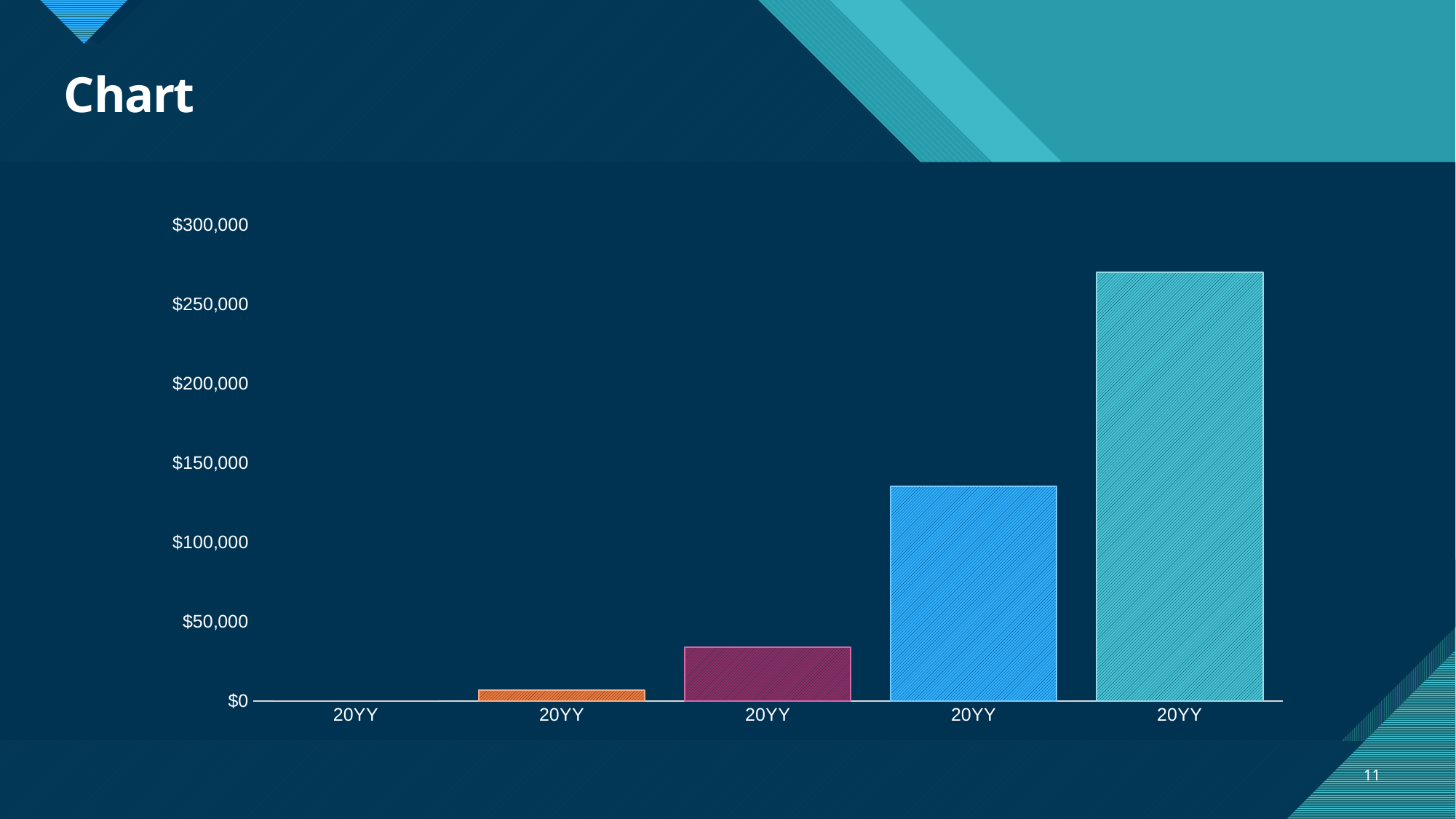
Is the value of the fourth bar from the left greater or less than $150,000? less Which bar is the lowest in the chart? the leftmost (first) bar Is the value of the fourth bar from the left greater or less than $100,000? greater Is the value of the rightmost (fifth) bar greater or less than $250,000? greater What is the title of the slide containing the chart? Chart How many categories are shown on the x axis of the chart? 5 Which bar is the highest in the chart? the rightmost (fifth) bar Do the bar values rise or fall from left to right along the x axis? rise What is the highest value shown on the y axis of the chart? $300,000 Which is larger, the fourth bar from the left or the third bar from the left? the fourth bar What kind of chart is shown on the slide? bar chart